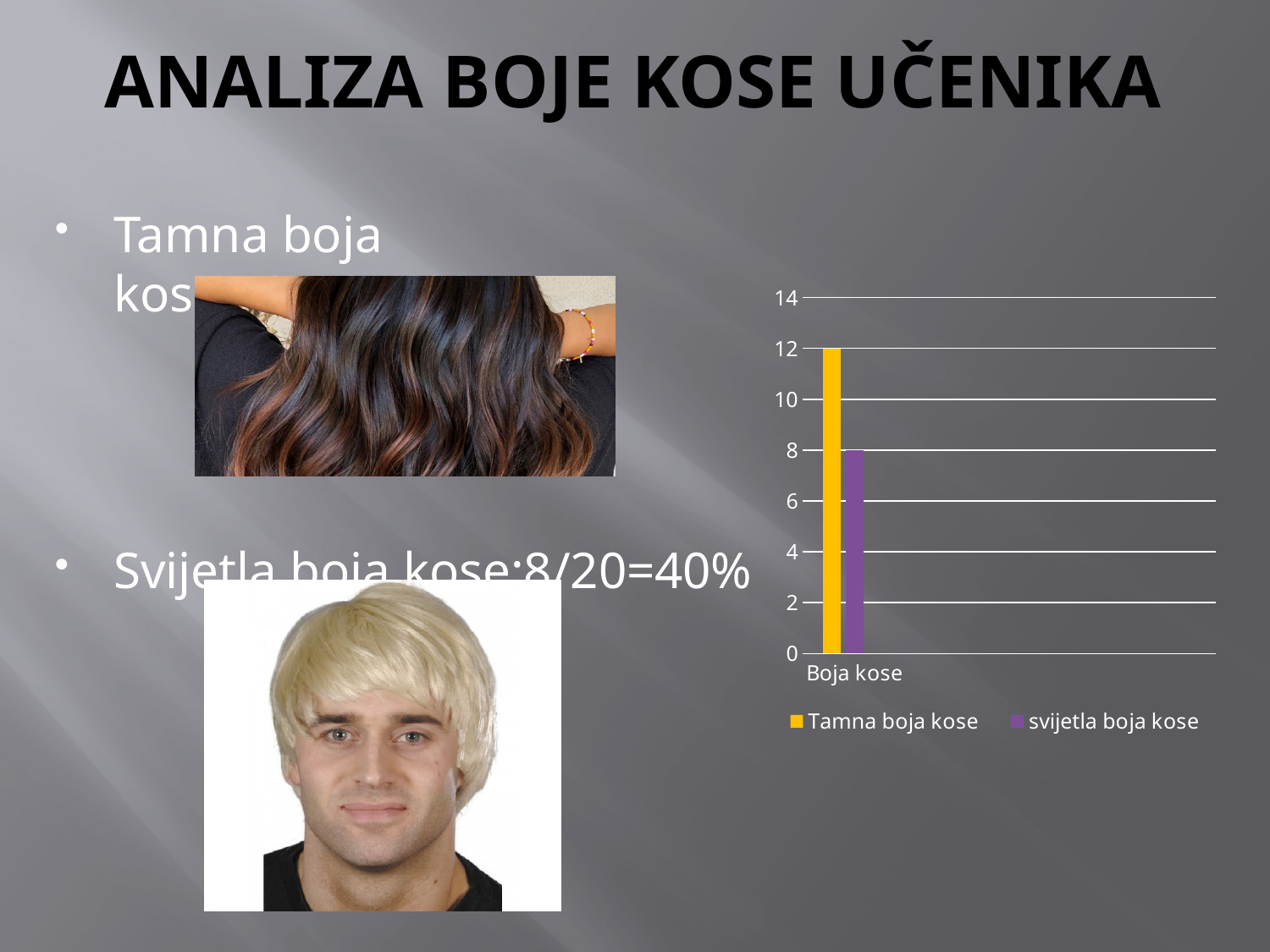
Is the value for svijetla boja kose greater or less than 10? less What is the category label shown on the x axis of the chart? Boja kose Which is larger, the Tamna boja kose bar or the svijetla boja kose bar? Tamna boja kose What type of chart is shown on the slide? bar chart What is the value of the Tamna boja kose bar? 12 Which series has the higher bar in the chart? Tamna boja kose What colour is the Tamna boja kose series in the chart? yellow How many categories are shown on the x axis of the chart? 1 What is the value of the svijetla boja kose bar? 8 What is the difference between the Tamna boja kose bar and the svijetla boja kose bar? 4 Which series has the lower bar in the chart? svijetla boja kose How many series does the chart legend list? 2